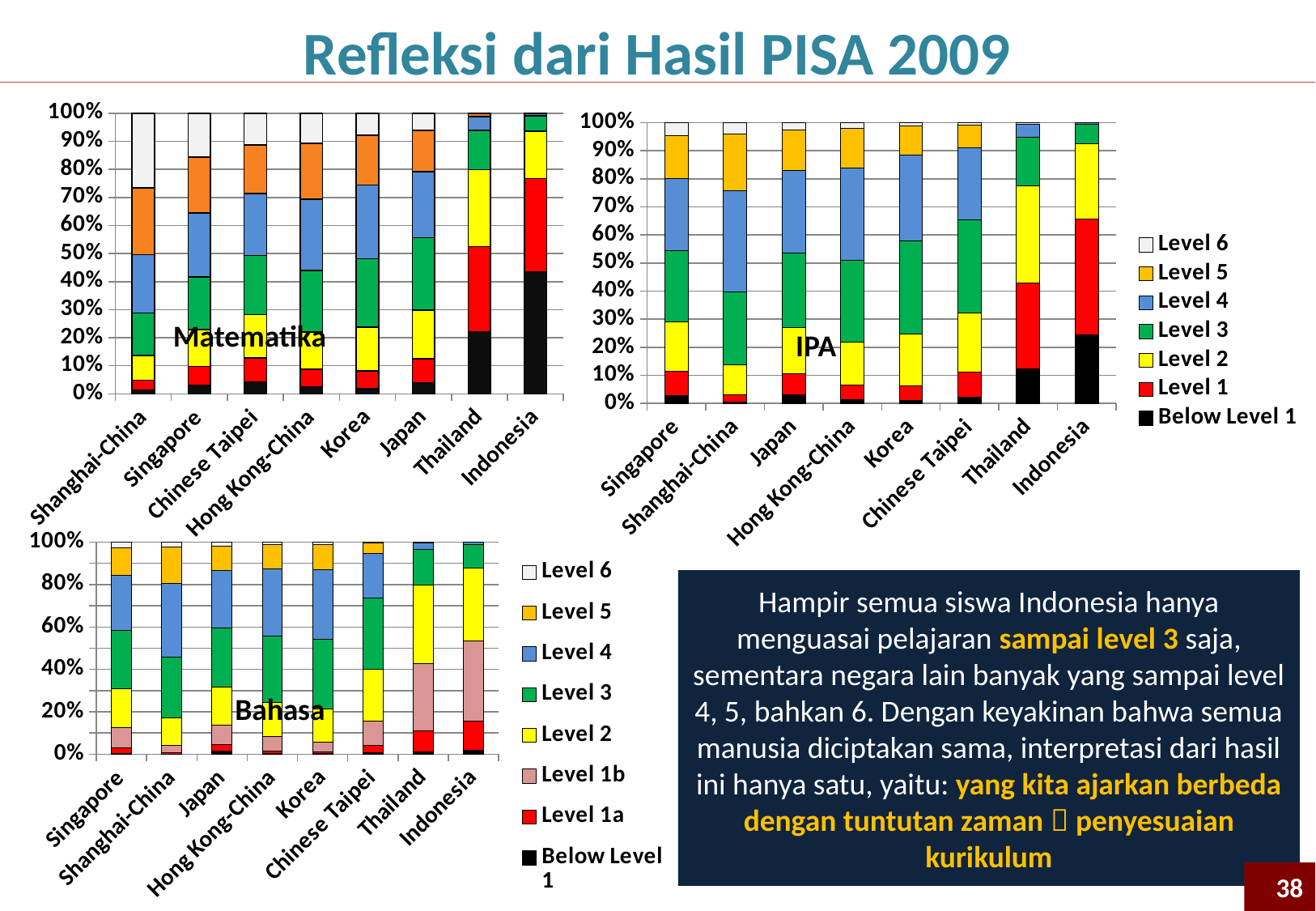
In the Matematika chart, which country has the largest Below Level 1 share? Indonesia In the IPA chart, which is larger, the Level 1 share for Indonesia or the Level 1 share for Thailand? Indonesia In the Matematika chart, is the Below Level 1 share for Indonesia greater or less than 30%? greater In the IPA chart, which country has the largest Below Level 1 share? Indonesia How many countries are shown on the Bahasa chart? 8 How many countries are shown on the Matematika chart? 8 How many series does the legend of the Bahasa chart list? 8 In the IPA chart, is the Below Level 1 share for Thailand greater or less than 20%? less How many series does the legend of the IPA chart list? 7 In the Matematika chart, which country has the largest Level 6 share? Shanghai-China What kind of chart is the Matematika chart? stacked bar chart